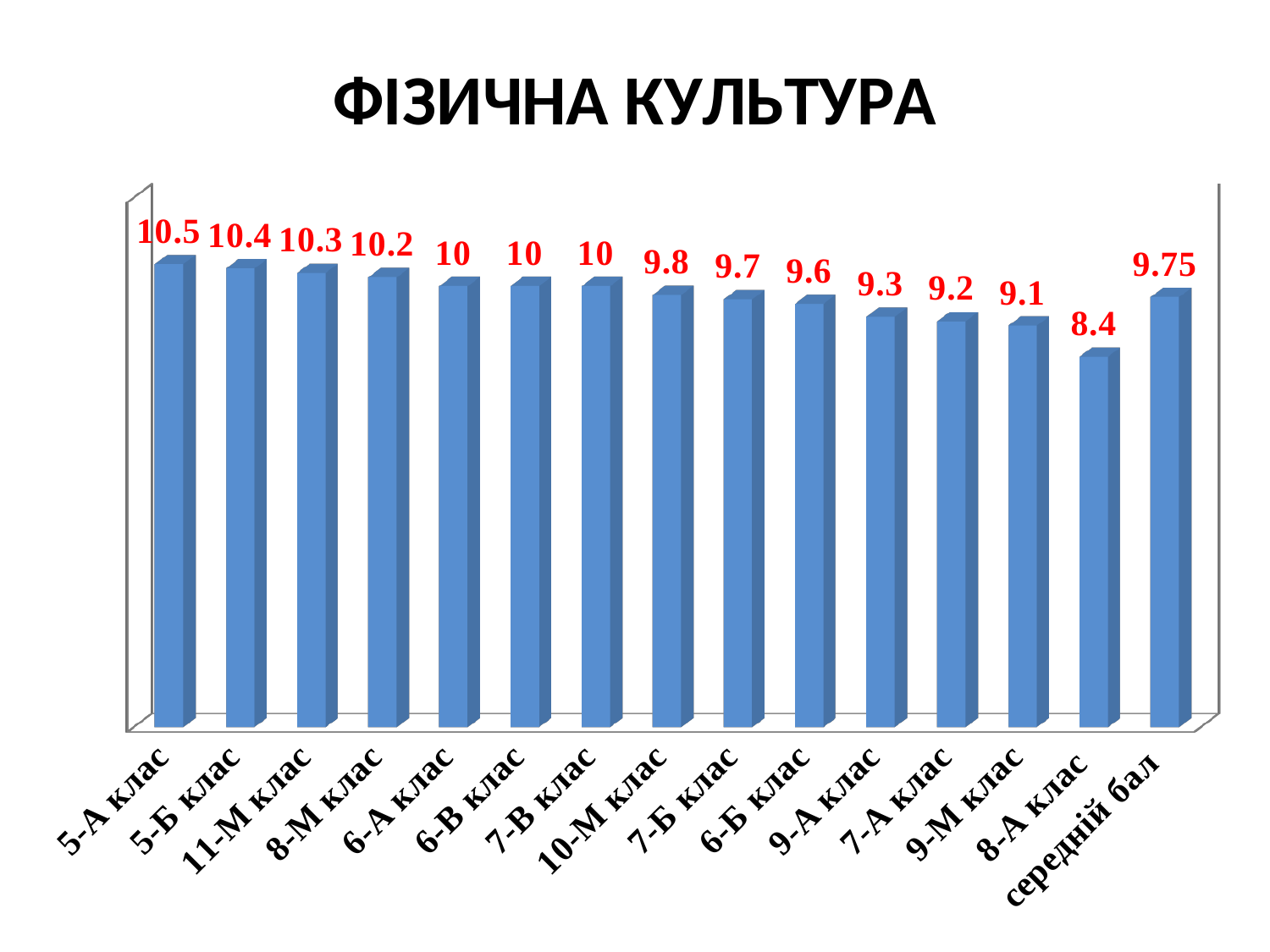
Which category has the highest value? 5-А клас What is the value for 10-М клас? 9.8 How many categories are shown on the x axis? 15 What is the value for 5-А клас? 10.5 What is the title of the chart? ФІЗИЧНА КУЛЬТУРА What is the difference between the values for 5-А клас and 8-А клас? 2.1 Which category has the lowest value? 8-А клас Which is larger, the value for 9-А клас or the value for 7-Б клас? 7-Б клас What is the value for 8-А клас? 8.4 Do the values for the classes rise or fall from 5-А клас to 8-А клас along the x axis? fall What is the value for середній бал? 9.75 What kind of chart is shown on the slide? bar chart